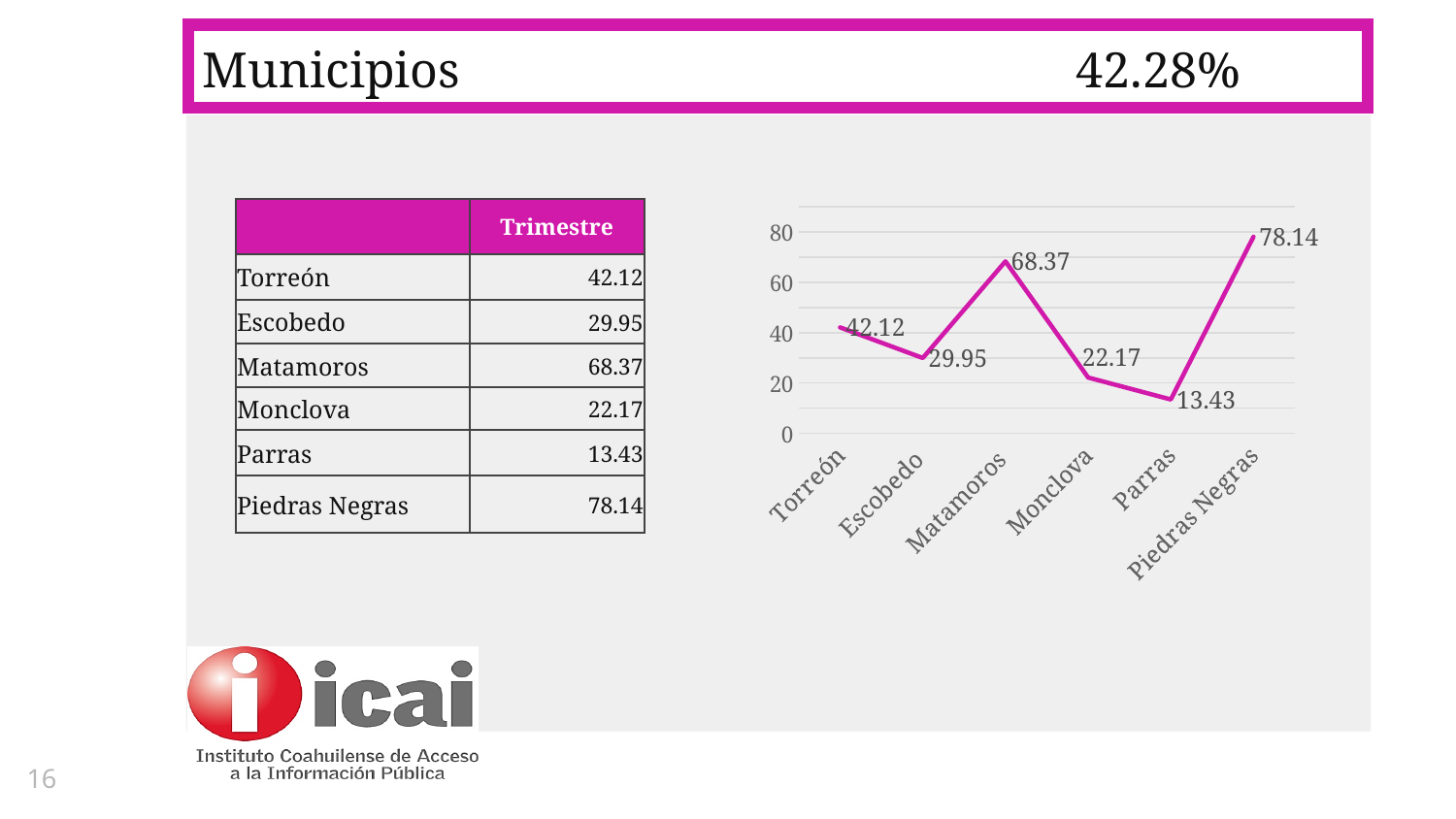
What is the difference between the values for Piedras Negras and Matamoros? 9.77 What is the difference between the values for Torreón and Escobedo? 12.17 Is the value for Matamoros greater or less than 60? greater What is the value for Parras on the line chart? 13.43 Which is larger, the value for Monclova or the value for Escobedo? Escobedo What kind of chart is shown on the slide? line chart What is the value for Torreón on the line chart? 42.12 Which municipality has the highest value on the chart? Piedras Negras What is the value for Matamoros on the line chart? 68.37 What is the highest value shown on the chart's vertical axis? 80 How many municipalities are plotted on the chart? 6 Which municipality has the lowest value on the chart? Parras